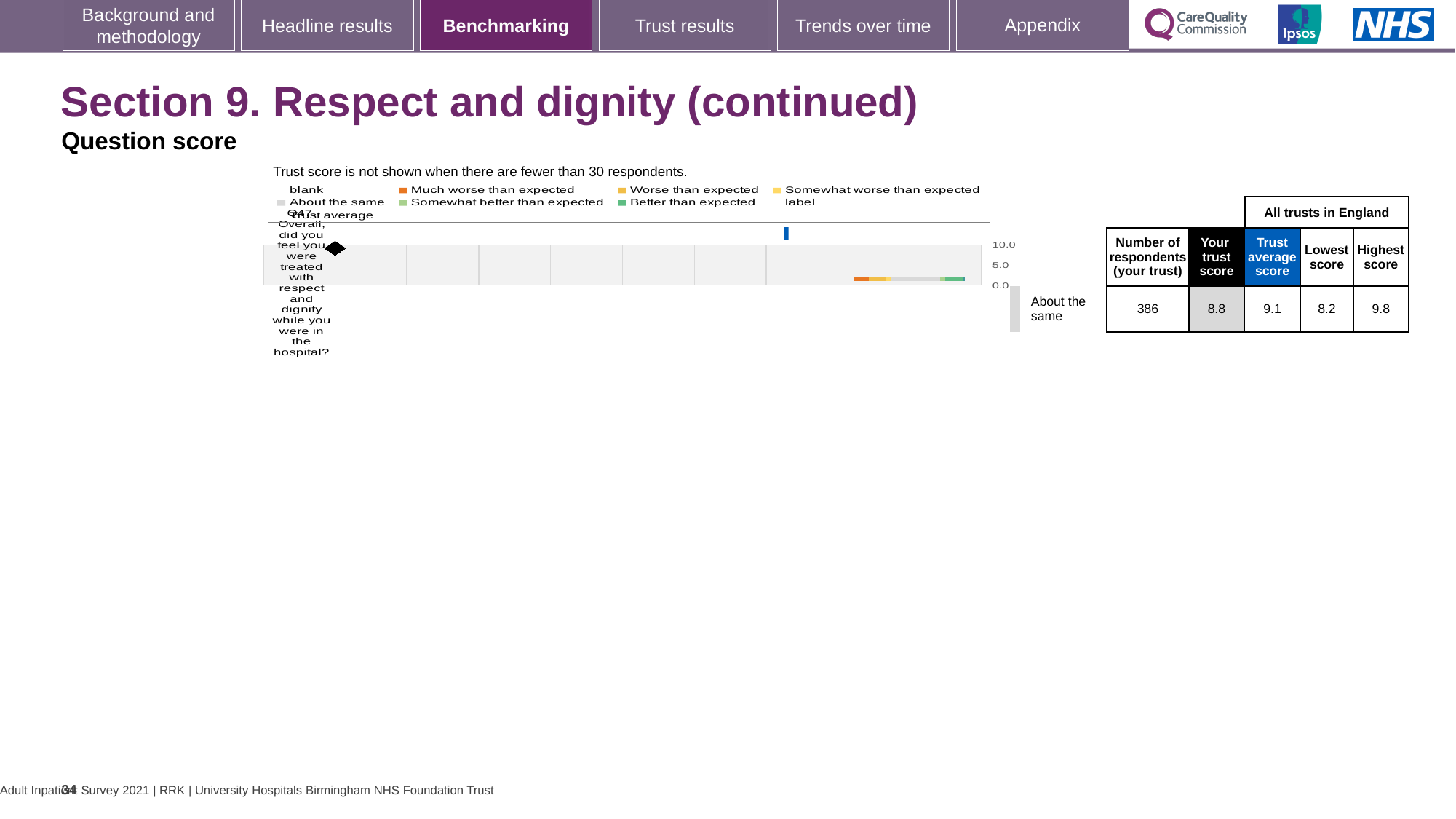
How many questions (categories) are plotted on the chart? 1 What benchmark rating is shown next to the chart for Q47? About the same What is the difference between the highest score and the lowest score for Q47? 1.6 What kind of chart is shown on the slide? bar chart What is the trust average score for Q47 shown in the table beside the chart? 9.1 What is the trust's score for Q47 shown in the table beside the chart? 8.8 What is the highest score across all trusts in England for Q47? 9.8 Which question number is plotted on the chart? Q47 Which is larger for Q47, the trust's score or the trust average score? trust average score What is the highest value shown on the chart's axis? 10.0 What is the number of respondents for Q47 shown in the table beside the chart? 386 What is the lowest score across all trusts in England for Q47? 8.2